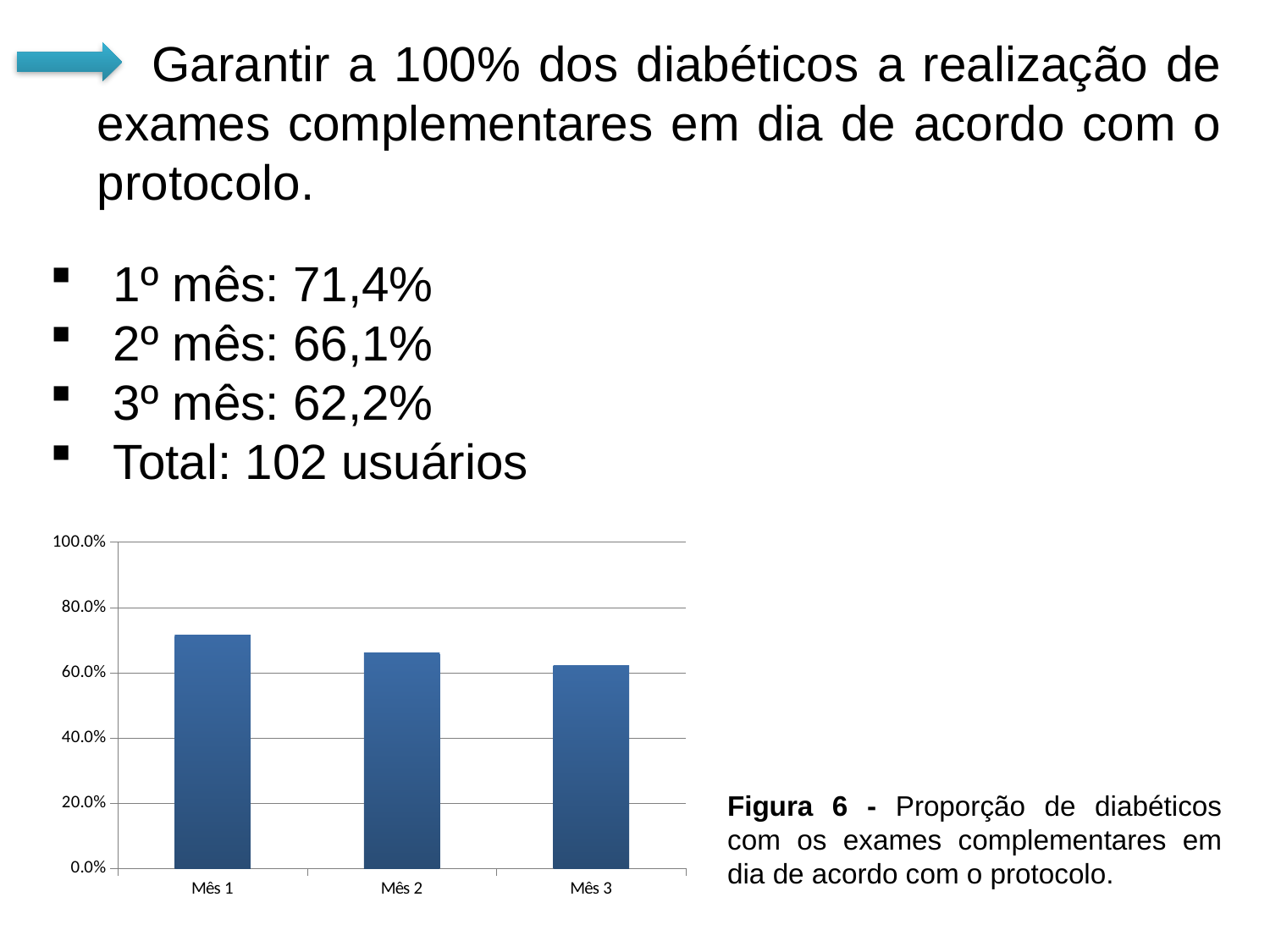
Which is larger, the value for Mês 1 or the value for Mês 3? Mês 1 Do the values rise or fall from Mês 1 to Mês 3? fall Is the value for Mês 1 greater or less than 80.0%? less According to the slide text, what proportion does the bar for Mês 2 represent? 66,1% What kind of chart is shown on the slide? bar chart What is the figure number given in the caption of the chart? Figura 6 Is the value for Mês 1 greater or less than 60.0%? greater How many bars (categories) does the chart show? 3 Is the value for Mês 3 greater or less than 80.0%? less Which month has the lowest bar in the chart? Mês 3 Which month has the highest bar in the chart? Mês 1